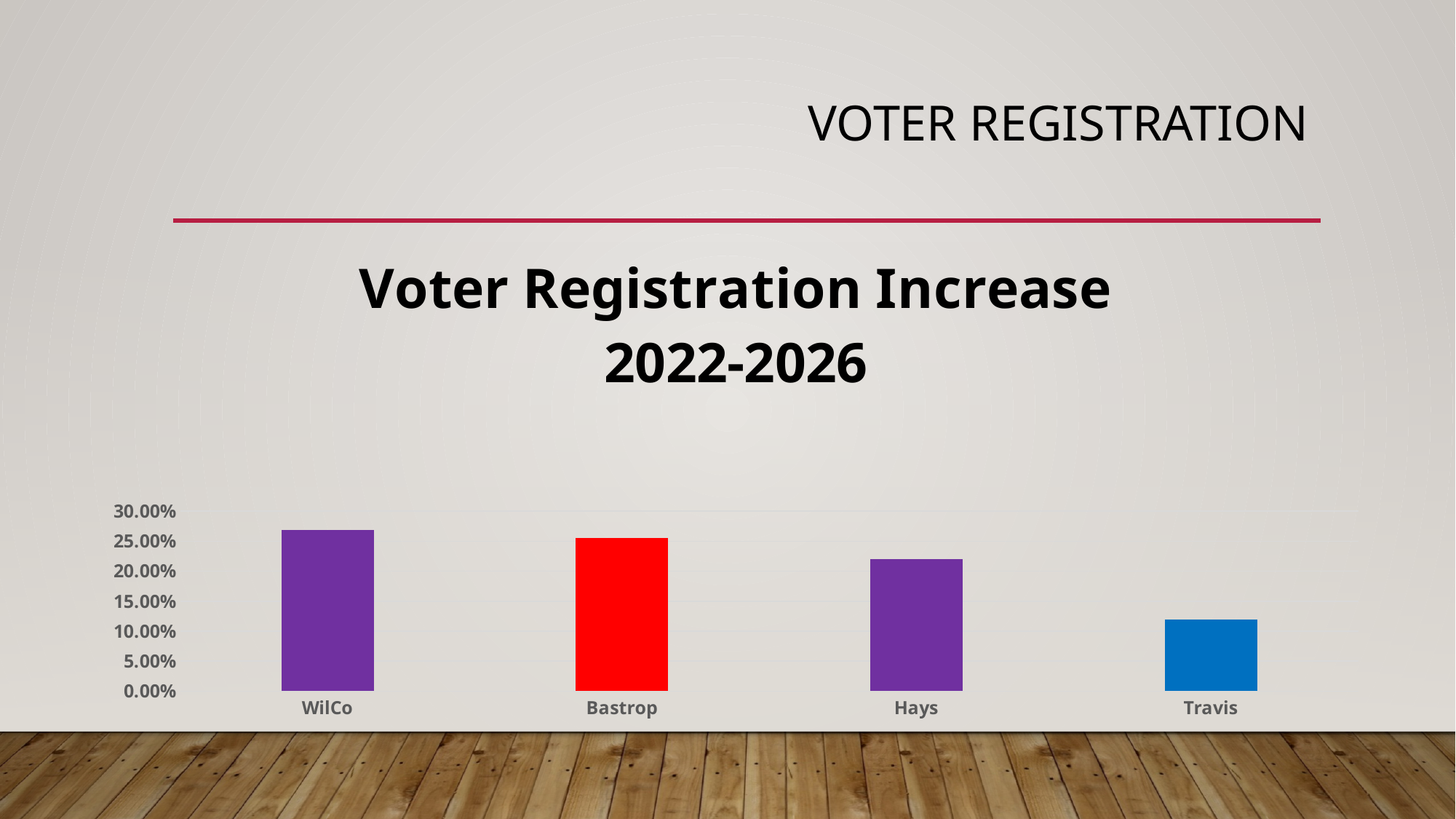
Do the values rise or fall moving from WilCo to Travis along the x axis? fall What kind of chart is shown on the slide? bar chart Which county has the lowest voter registration increase? Travis What colour is the bar for Bastrop? red Which is larger, the value for Bastrop or the value for Hays? Bastrop Is the value for Travis greater or less than 10.00%? greater Is the value for Travis greater or less than 15.00%? less Is the value for Hays greater or less than 25.00%? less How many counties are shown on the chart? 4 What is the title of the chart? Voter Registration Increase 2022-2026